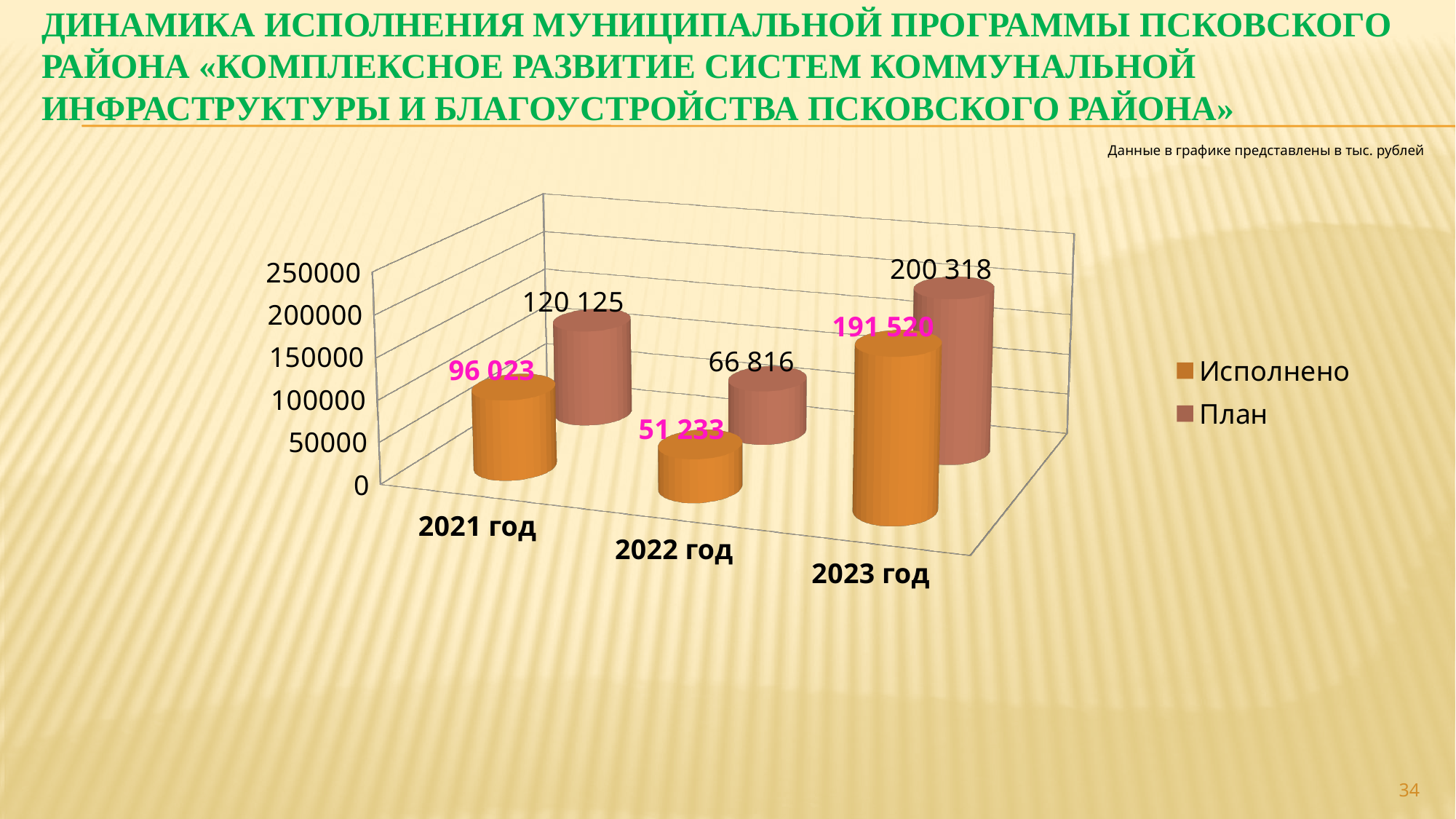
What is the difference between План and Исполнено for 2021 год? 24 102 In what units are the data in the chart presented, according to the note on the slide? тыс. рублей How many years are shown on the x axis? 3 What is the difference between План and Исполнено for 2023 год? 8 798 What is the value of Исполнено for 2021 год? 96 023 What kind of chart is shown on the slide? Bar chart What is the value of План for 2022 год? 66 816 Which year has the lowest План value? 2022 год What is the value of План for 2023 год? 200 318 Which year has the highest Исполнено value? 2023 год How many series does the legend list? 2 Which is larger for 2022 год, Исполнено or План? План